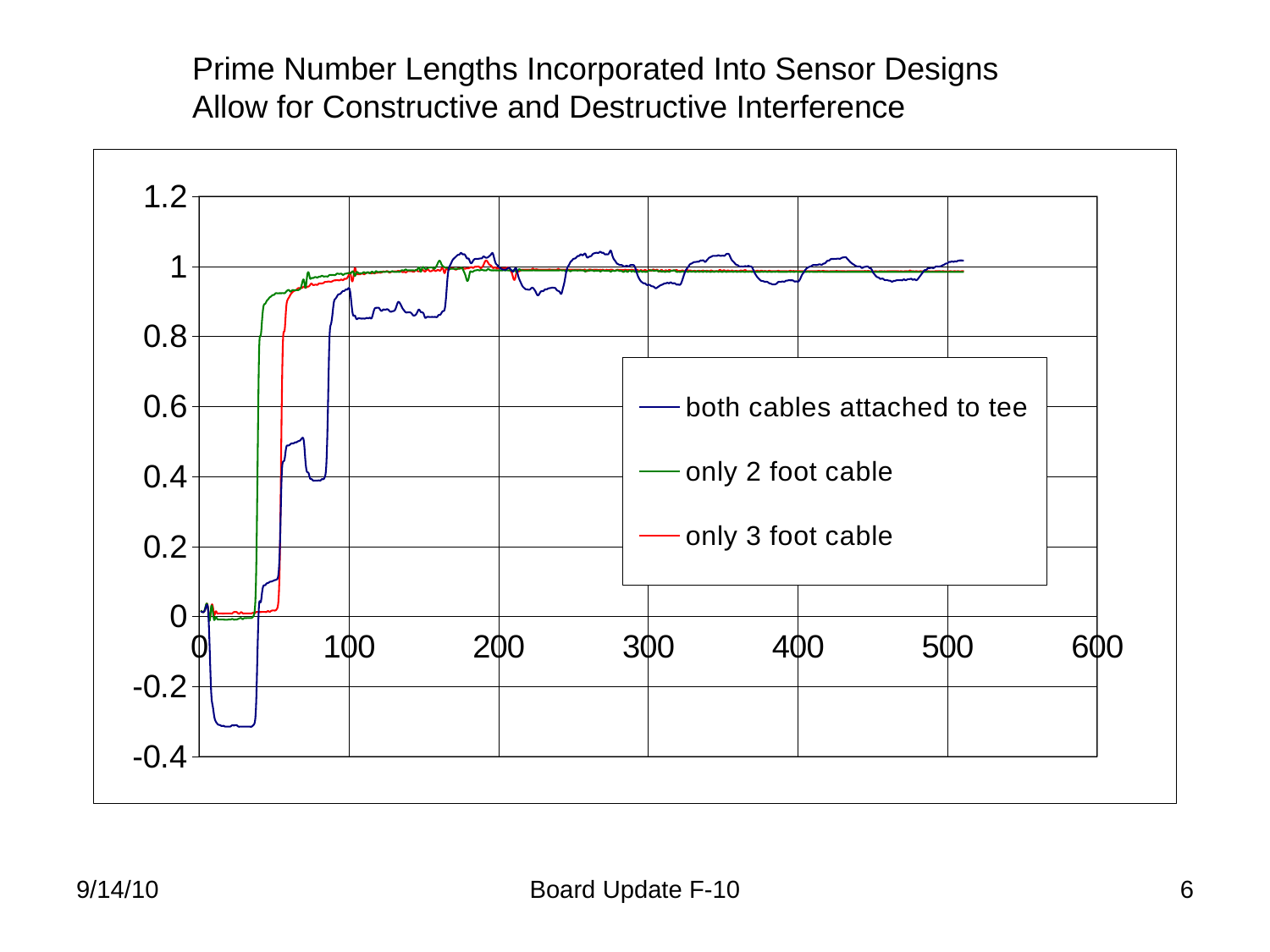
Is the value of the 'both cables attached to tee' series at x = 20 greater or less than -0.2? less What kind of chart is shown on the slide? line chart Which colour is used for the 'only 3 foot cable' series? red Is the value of the 'only 3 foot cable' series at x = 20 greater or less than 0.2? less Is the value of the 'both cables attached to tee' series at x = 70 greater or less than 0.2? greater How many series does the legend list? 3 What are the three series named in the legend? both cables attached to tee, only 2 foot cable, only 3 foot cable Which series reaches the lowest value on the chart? both cables attached to tee At x = 40, which series has the larger value: 'only 2 foot cable' or 'both cables attached to tee'? only 2 foot cable Do the series values generally rise or fall as x increases from 0 to 100? rise